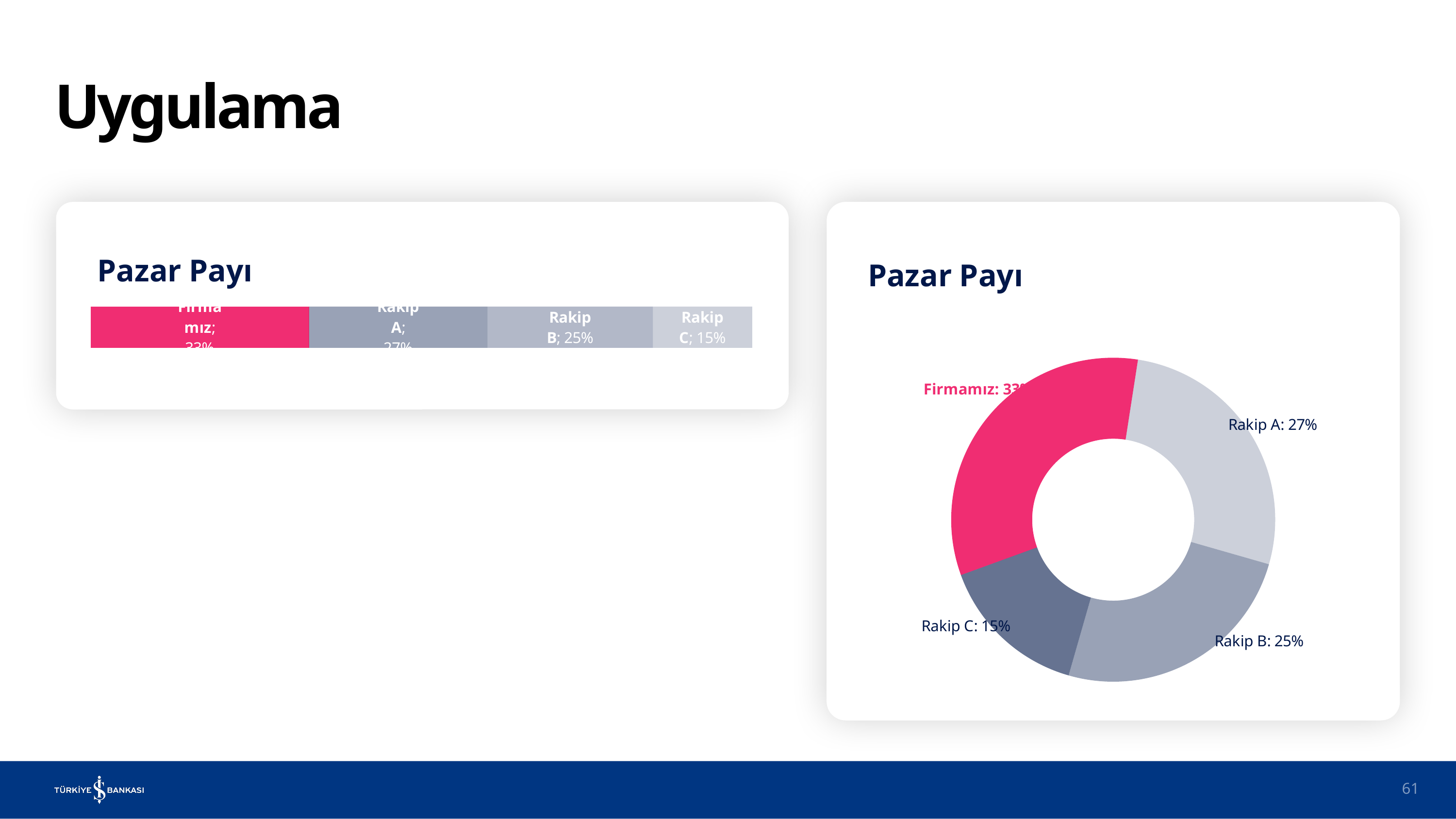
In the donut chart on the right, what is the difference between the shares of Rakip A and Rakip C? 12% How many categories are shown in the donut chart on the right? 4 In the donut chart on the right, what is the share for Rakip C? 15% In the donut chart on the right, what is the share for Rakip B? 25% In the stacked bar chart on the left, what is the value for Rakip B? 25% In the donut chart on the right, which is larger: the share of Rakip B or the share of Rakip C? Rakip B In the donut chart on the right, which category has the smallest share? Rakip C In the donut chart on the right, what is the share for Rakip A? 27% What kind of chart is the chart on the left side of the slide? bar chart In the stacked bar chart on the left, what is the value for Rakip C? 15% In the donut chart on the right, which category has the largest share? Firmamız What kind of chart is the chart on the right side of the slide? donut chart